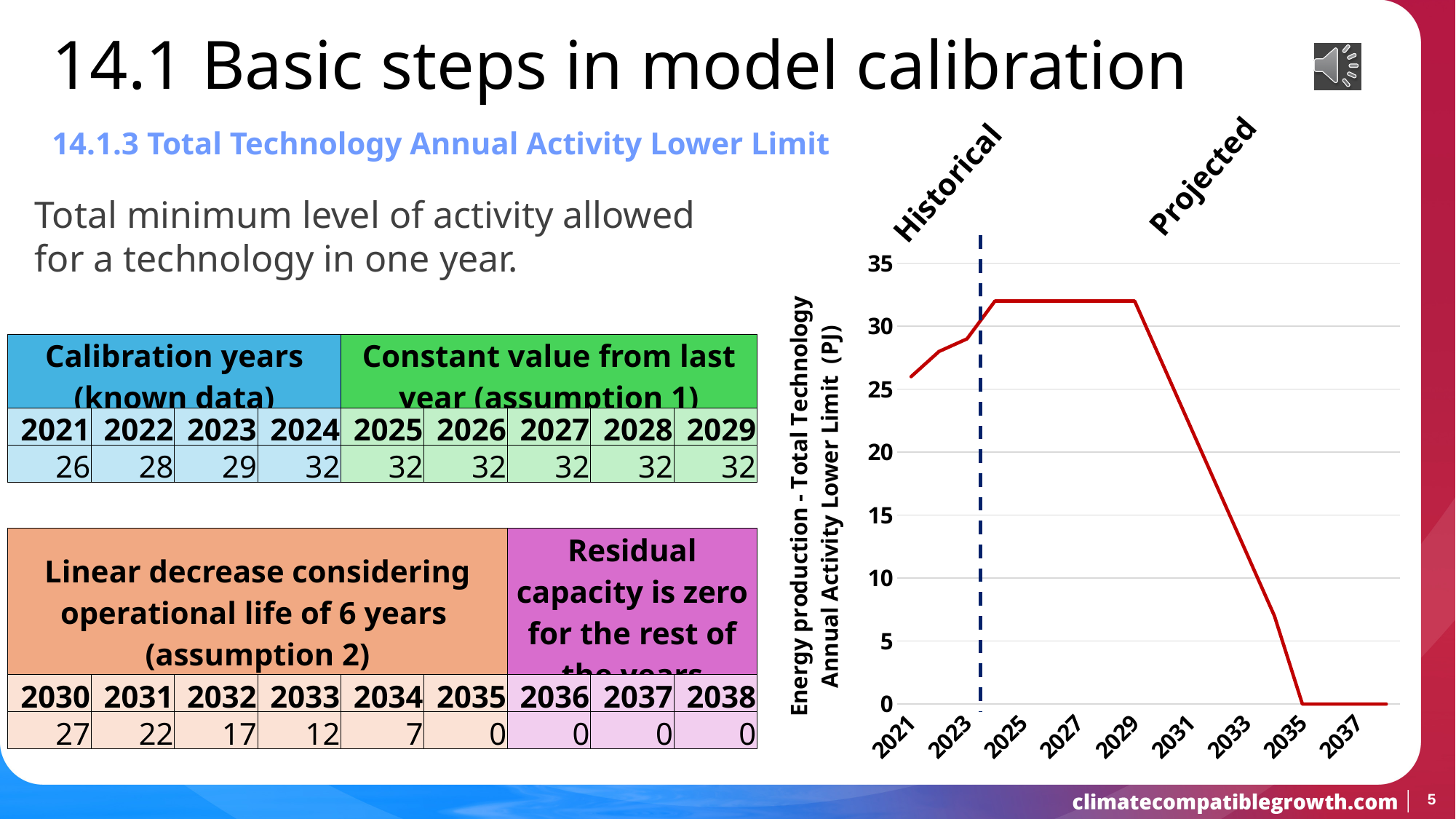
What is the value plotted for 2024? 32 What is the difference between the values for 2024 and 2021? 6 What is the value plotted for 2032? 17 What is the value plotted for 2034? 7 Is the value for 2033 greater or less than 15? less What kind of chart is shown on the right of the slide? line chart What is the highest value reached by the line? 32 Does the line rise or fall between 2029 and 2035? fall What two labels appear on either side of the dashed vertical line on the chart? Historical and Projected What is the Total Technology Annual Activity Lower Limit value for 2021? 26 Which year has the larger value, 2030 or 2031? 2030 How many years are plotted on the chart, from 2021 to 2038? 18